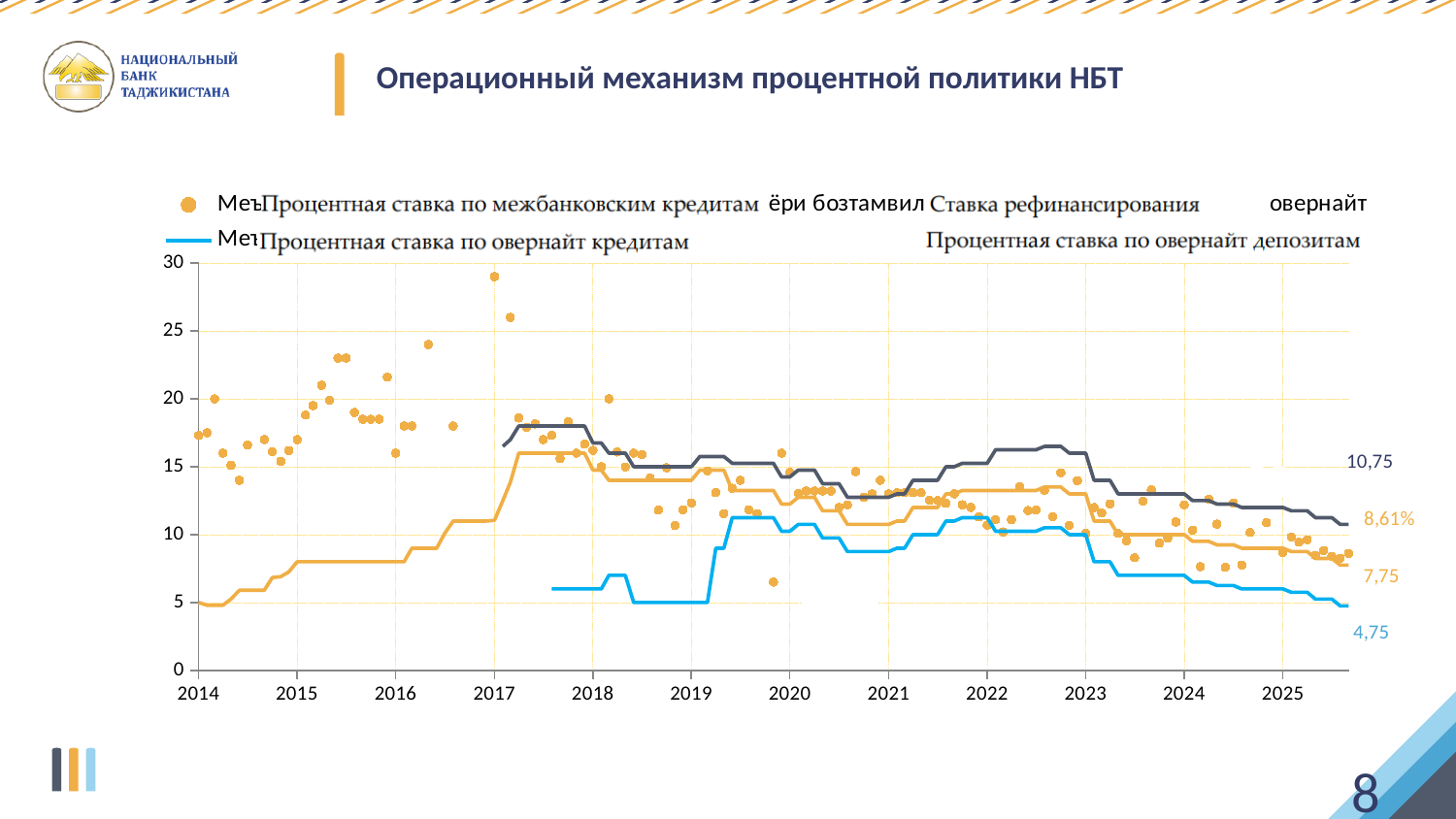
What value is labelled at the end of the dark gray line in 2025? 10,75 At the end of the chart in 2025, which is higher: the dark gray line or the blue line? the dark gray line What is the difference between the end labels of the dark gray line (10,75) and the blue line (4,75)? 6 Does the blue line rise or fall between 2020 and 2025? fall What kind of chart is shown on the slide? line chart Is the value of the blue line at the start of 2019 greater or less than 10? less What value is labelled at the end of the blue line in 2025? 4,75 What value is labelled at the end of the orange line in 2025? 7,75 Is the value of the dark gray line at the start of 2018 greater or less than 15? greater What value is labelled next to the last orange dots in 2025? 8,61% How many series does the chart legend list? 4 What is the title of the chart on the slide? Операционный механизм процентной политики НБТ